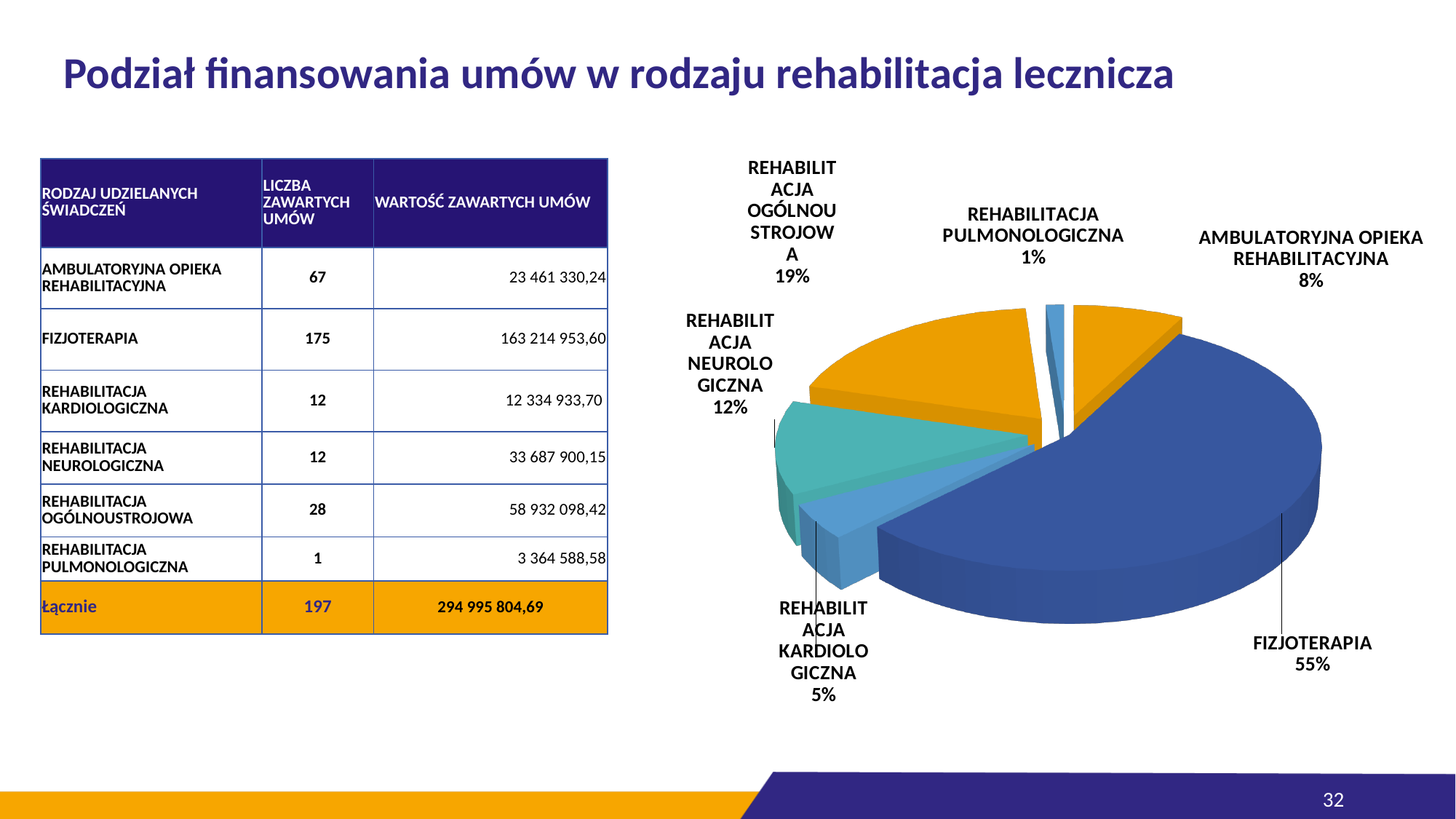
How many slices does the pie chart have? 6 Which slice of the pie chart is the smallest? REHABILITACJA PULMONOLOGICZNA What share of the pie does REHABILITACJA KARDIOLOGICZNA have? 5% What share of the pie does REHABILITACJA OGÓLNOUSTROJOWA have? 19% What share of the pie does REHABILITACJA NEUROLOGICZNA have? 12% What kind of chart is shown on the slide? pie chart Which slice is larger, REHABILITACJA NEUROLOGICZNA or AMBULATORYJNA OPIEKA REHABILITACYJNA? REHABILITACJA NEUROLOGICZNA Which slice of the pie chart is the largest? FIZJOTERAPIA What is the difference in percentage points between the FIZJOTERAPIA slice and the REHABILITACJA OGÓLNOUSTROJOWA slice? 36